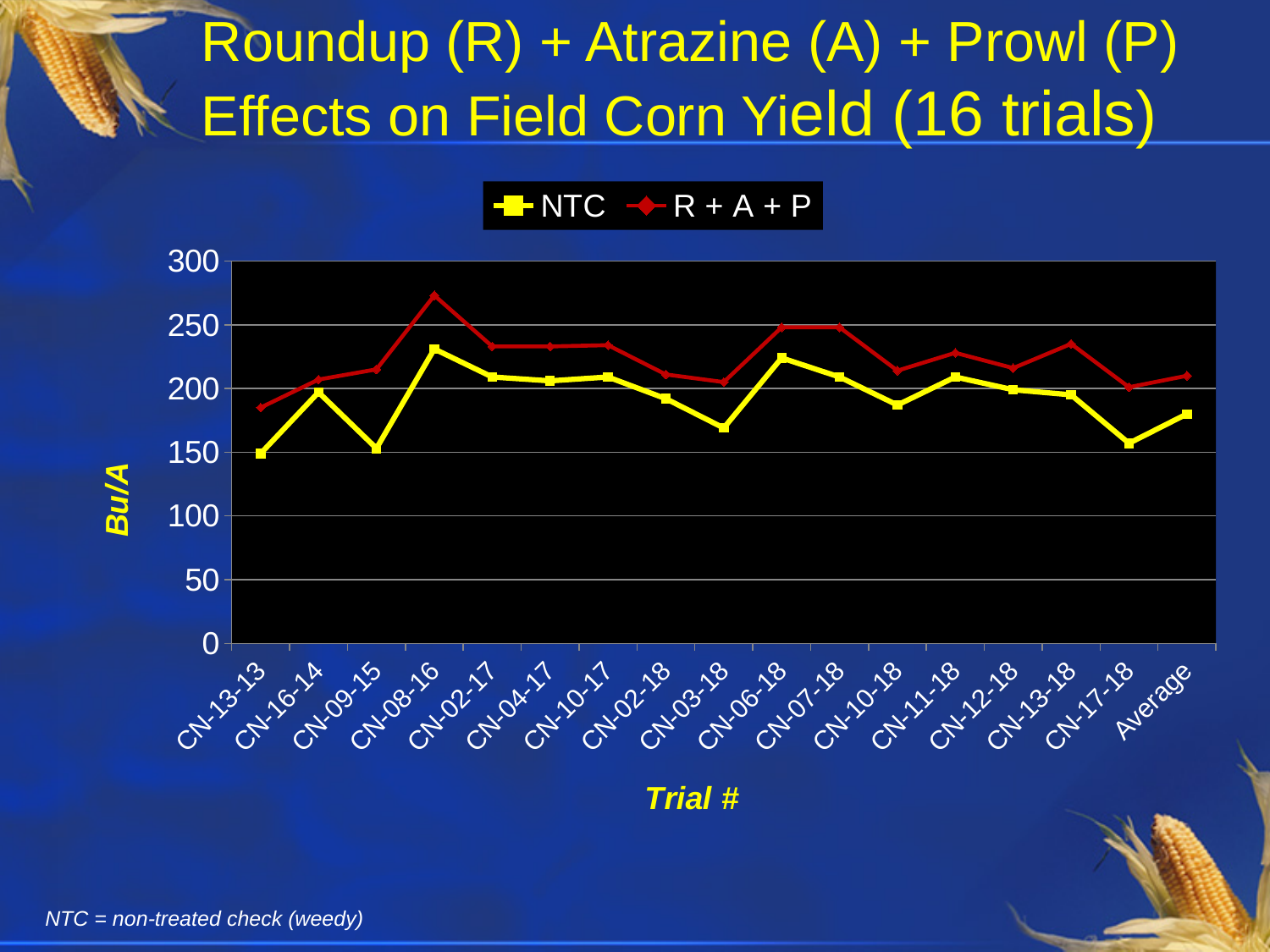
Is the NTC value for Average greater or less than 200? less Is the NTC value for CN-03-18 greater or less than 200? less What is the label on the y axis? Bu/A Is the R + A + P value for CN-08-16 greater or less than 250? greater What kind of chart is shown on the slide? line chart Which trial has the highest R + A + P value? CN-08-16 How many categories are plotted along the x axis? 17 What is the label on the x axis? Trial # At CN-08-16, which series has the larger value, NTC or R + A + P? R + A + P How many series does the legend list? 2